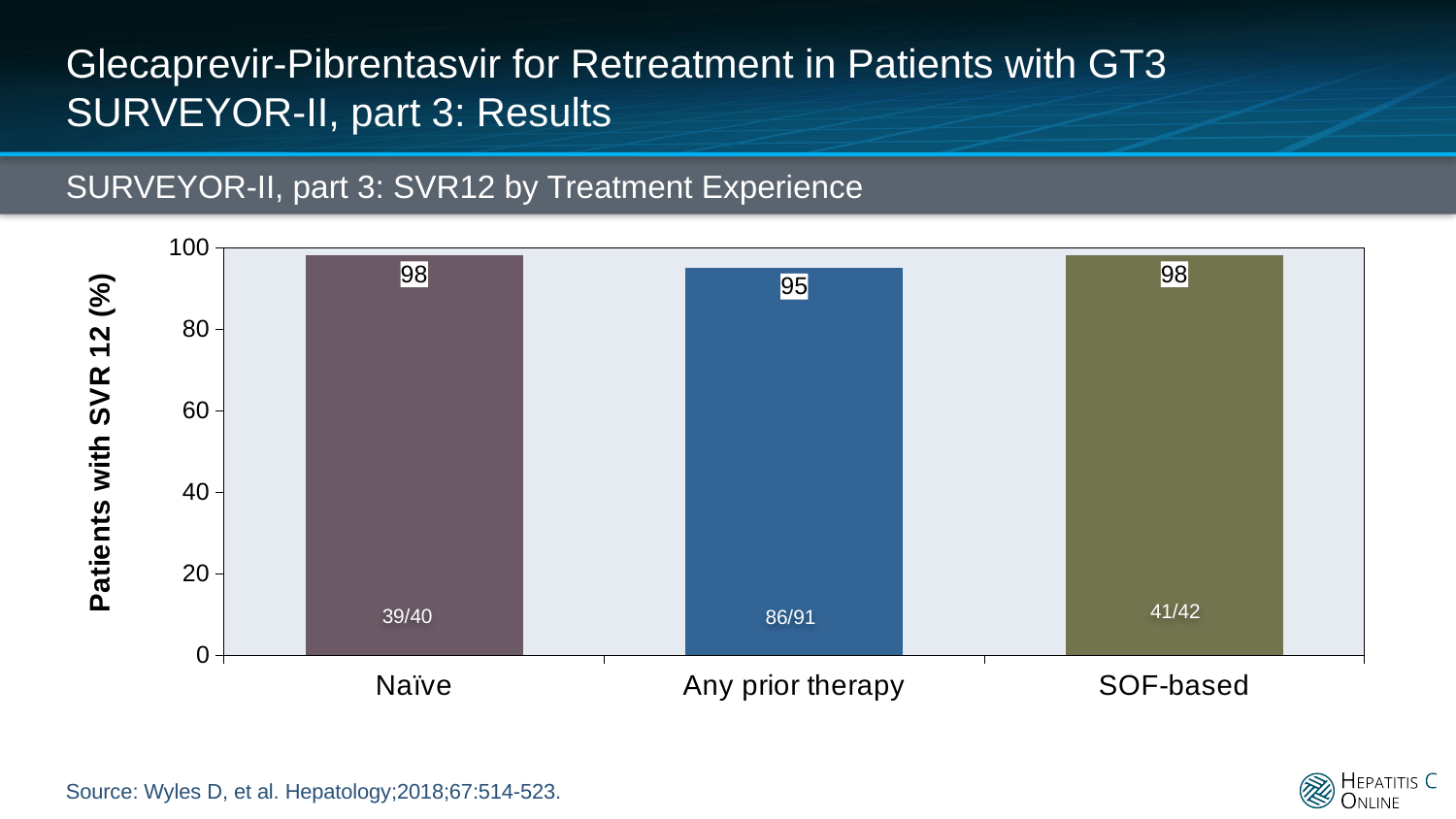
Which group has the lowest SVR12 rate? Any prior therapy What is the SVR12 rate for the Naïve group? 98 What fraction of patients is shown inside the SOF-based bar? 41/42 What is the SVR12 rate for the Any prior therapy group? 95 What is the difference in SVR12 rate between the Naïve group and the Any prior therapy group? 3 What type of chart is shown on the slide? Bar chart What fraction of patients is shown inside the Any prior therapy bar? 86/91 How many treatment experience groups are shown in the chart? 3 What is the title of the chart? SURVEYOR-II, part 3: SVR12 by Treatment Experience What is the SVR12 rate for the SOF-based group? 98 What is the label of the y-axis? Patients with SVR 12 (%) Which has a higher SVR12 rate, Naïve or Any prior therapy? Naïve